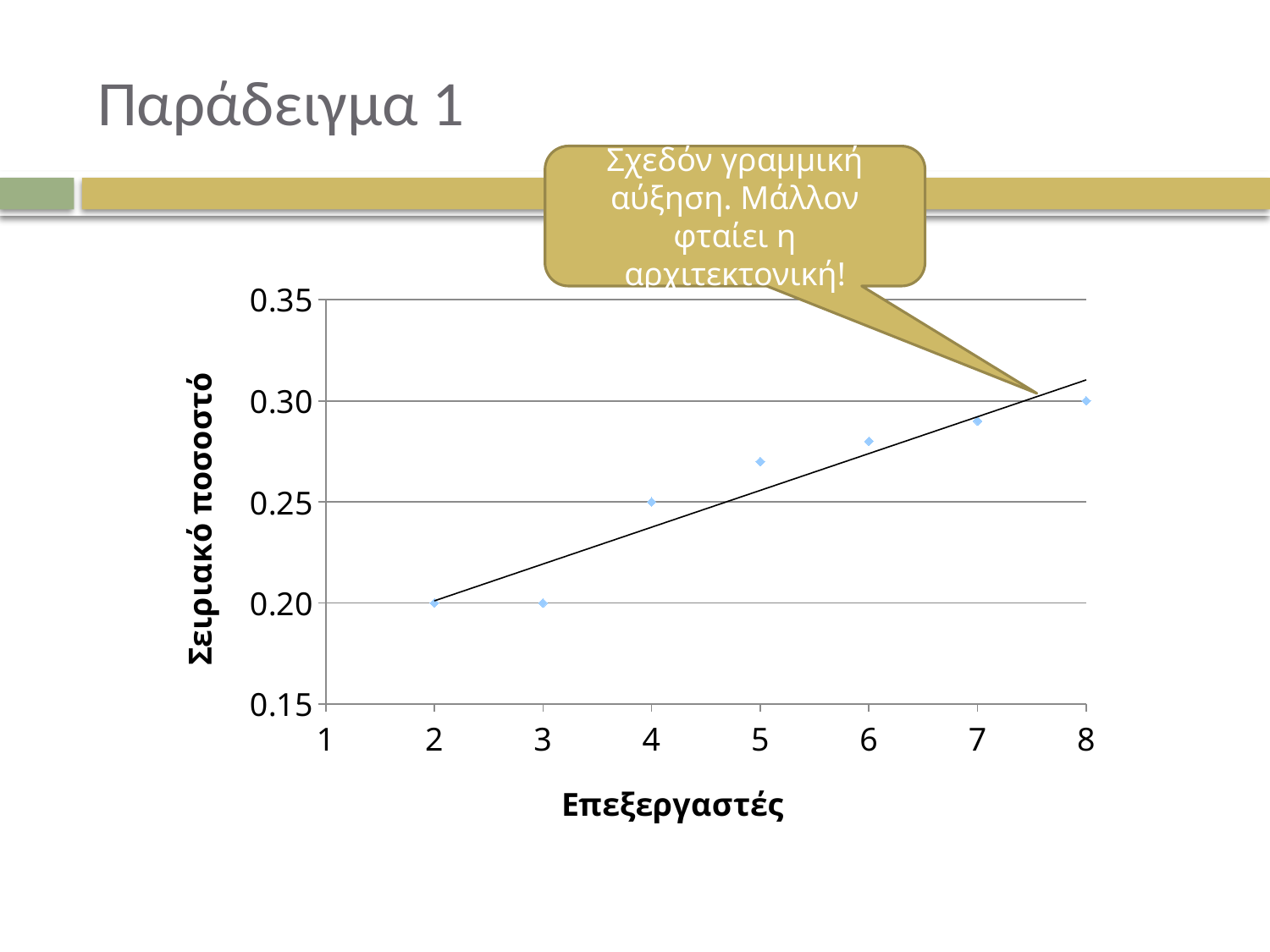
Is the value for 5 Επεξεργαστές greater or less than 0.25? greater Which is larger, the value for 4 Επεξεργαστές or the value for 7 Επεξεργαστές? 7 Επεξεργαστές What is the value of Σειριακό ποσοστό for 2 Επεξεργαστές? 0.20 What is the title of the vertical axis? Σειριακό ποσοστό What is the value of Σειριακό ποσοστό for 8 Επεξεργαστές? 0.30 Is the value for 6 Επεξεργαστές greater or less than 0.30? less What is the difference between the values for 8 and 2 Επεξεργαστές? 0.10 Do the values rise or fall as the number of Επεξεργαστές increases? rise How many data points are plotted on the chart? 7 What kind of chart is shown on the slide? scatter chart What is the value of Σειριακό ποσοστό for 4 Επεξεργαστές? 0.25 Which number of Επεξεργαστές has the highest Σειριακό ποσοστό? 8